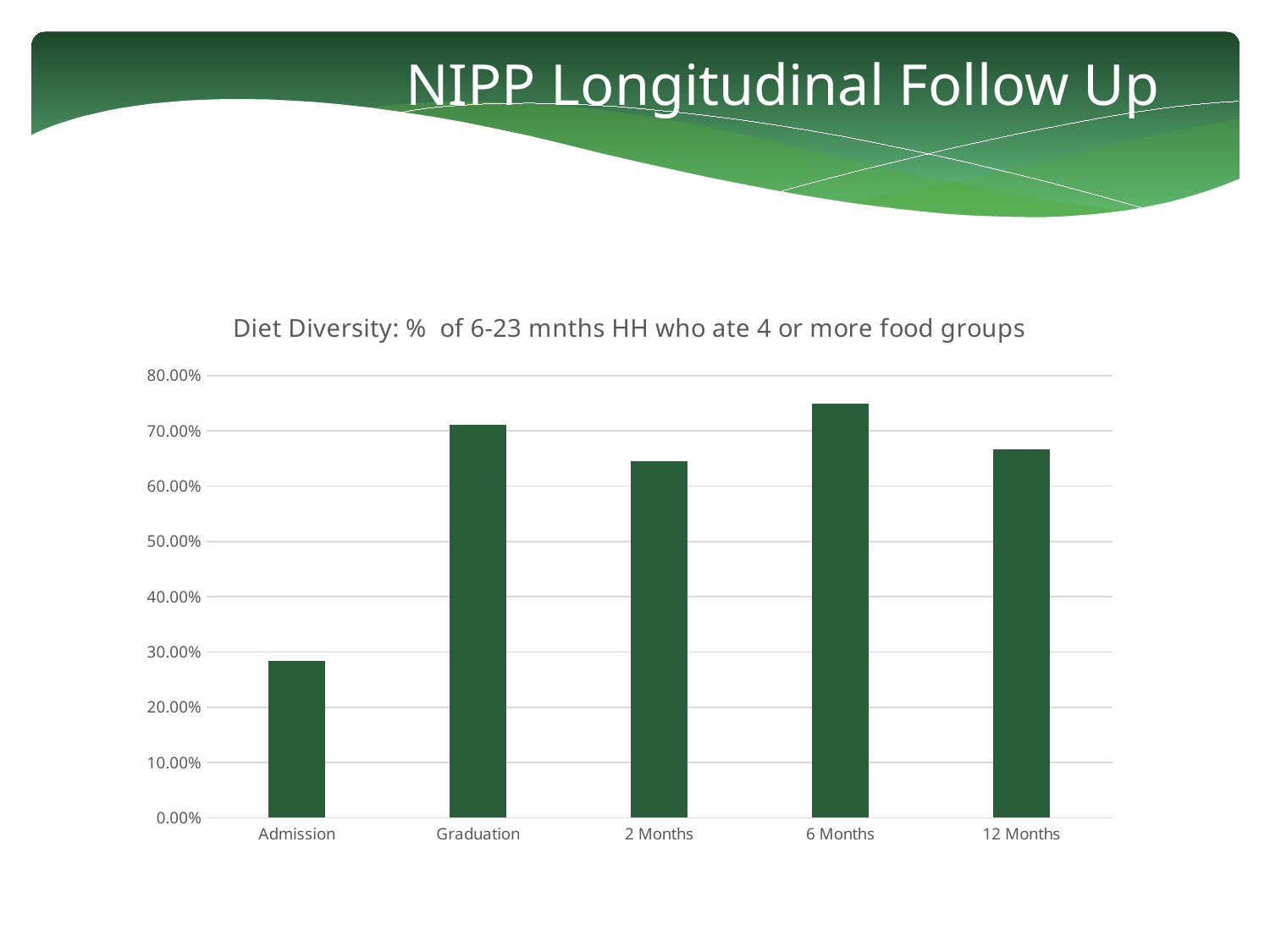
Is the value for Graduation greater or less than 60.00%? greater Is the value for 12 Months greater or less than 70.00%? less Which is larger, the value for Graduation or the value for 2 Months? Graduation How many categories are shown on the x axis of the chart? 5 Which category has the lowest value in the chart? Admission Which category has the highest value in the chart? 6 Months Is the value for 2 Months greater or less than 60.00%? greater What is the title of the chart? Diet Diversity: % of 6-23 mnths HH who ate 4 or more food groups Which is larger, the value for 6 Months or the value for 12 Months? 6 Months What kind of chart is shown on the slide? Bar chart